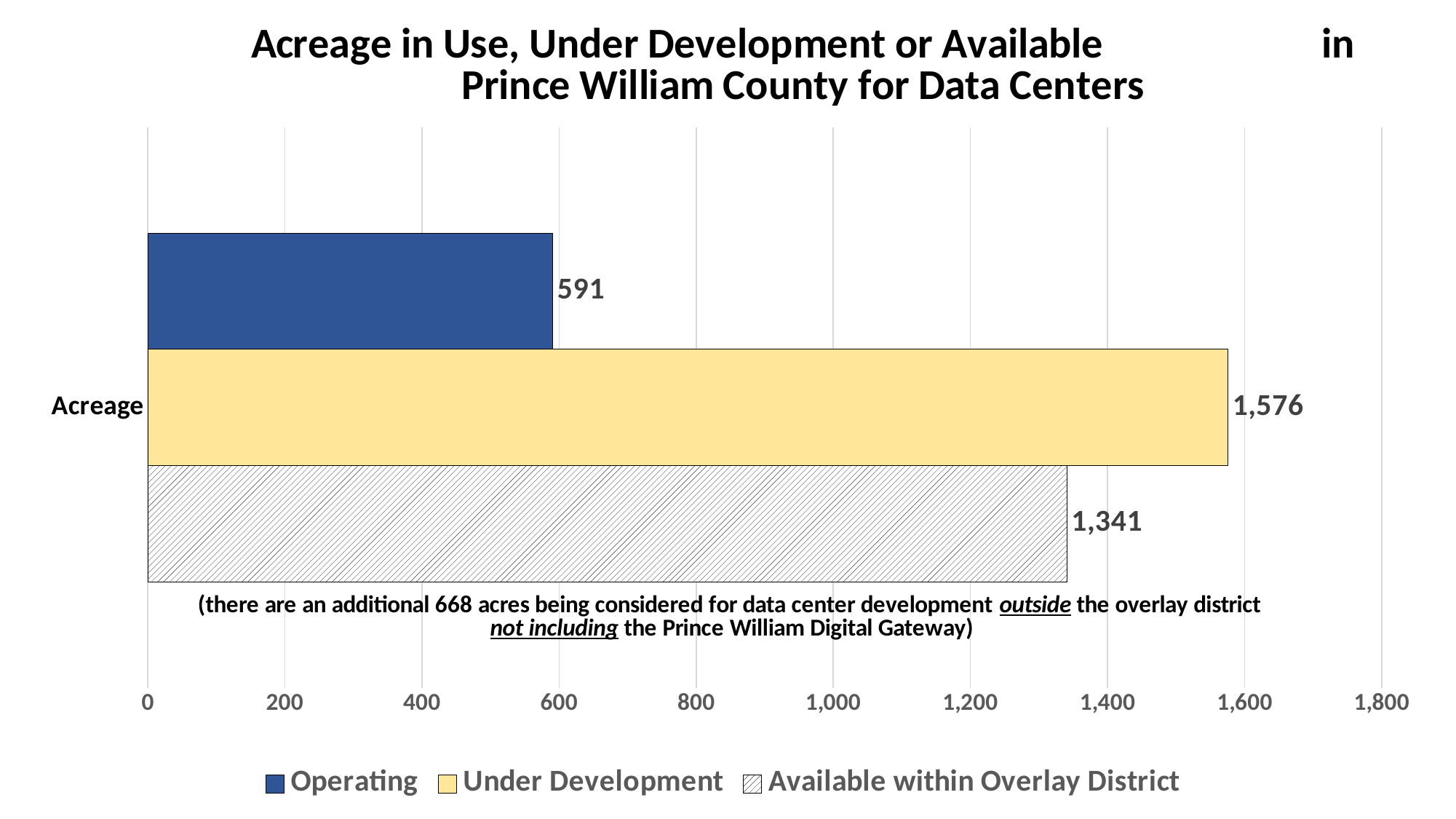
What is the difference in acreage between Under Development and Operating? 985 What is the difference in acreage between Under Development and Available within Overlay District? 235 Which series has the lowest acreage? Operating Which is larger, the Operating acreage or the Available within Overlay District acreage? Available within Overlay District What is the acreage Available within Overlay District? 1,341 What is the acreage Under Development? 1,576 What is the acreage for Operating data centers? 591 What is the highest value shown on the horizontal axis? 1,800 Which series has the highest acreage? Under Development Is the Operating acreage greater or less than 600? less How many series does the legend list? 3 What kind of chart is shown on the slide? bar chart